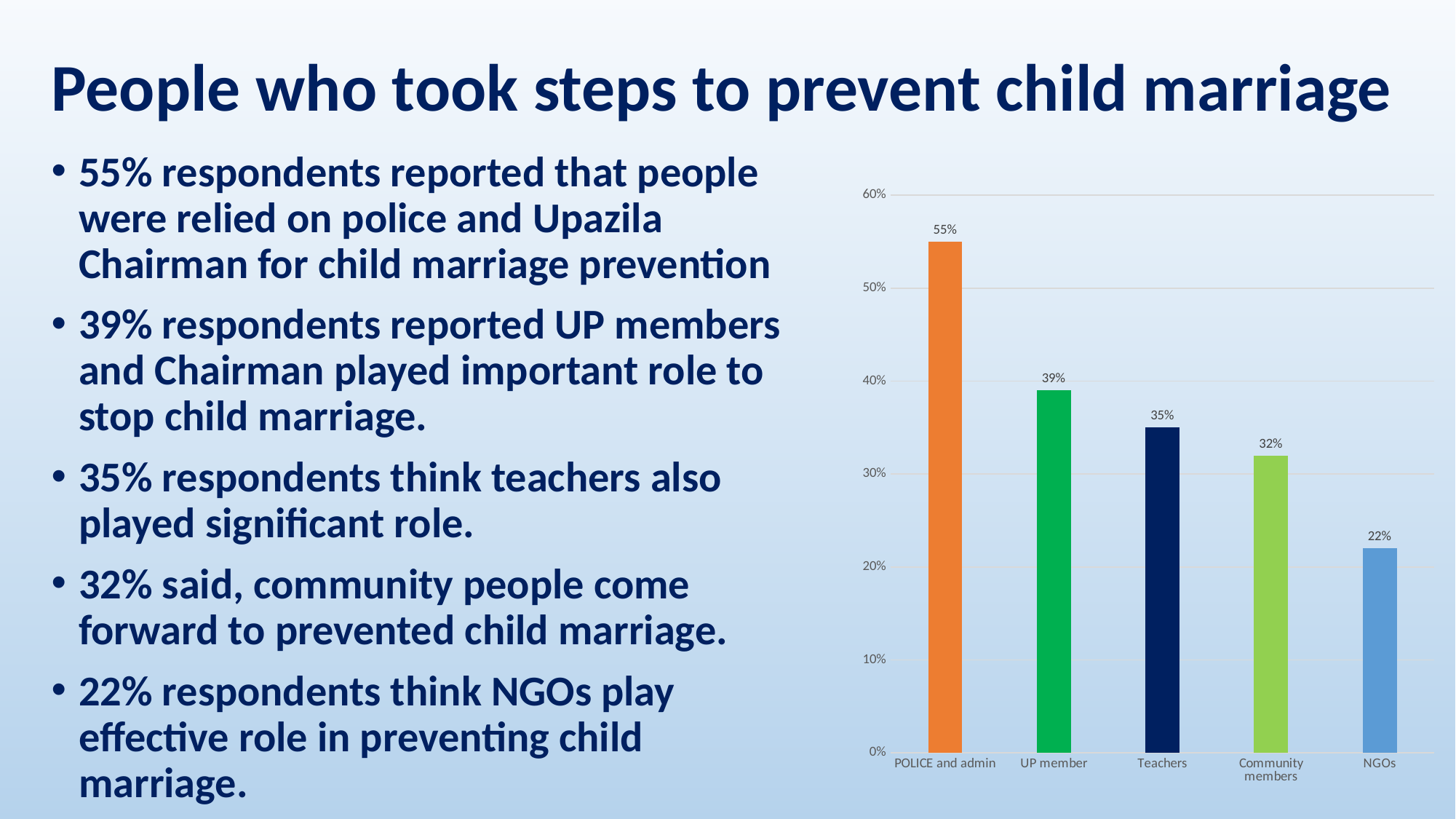
Which category has the highest value? POLICE and admin Do the values rise or fall from left to right along the x axis? Fall What is the value for UP member? 39% What is the value for Teachers? 35% How many categories are shown on the x axis? 5 What is the difference between the values for POLICE and admin and UP member? 16% What is the value for POLICE and admin? 55% What is the value for NGOs? 22% What is the value for Community members? 32% Which is larger, the value for Teachers or the value for Community members? Teachers Which category has the lowest value? NGOs What kind of chart is shown on the slide? Bar chart